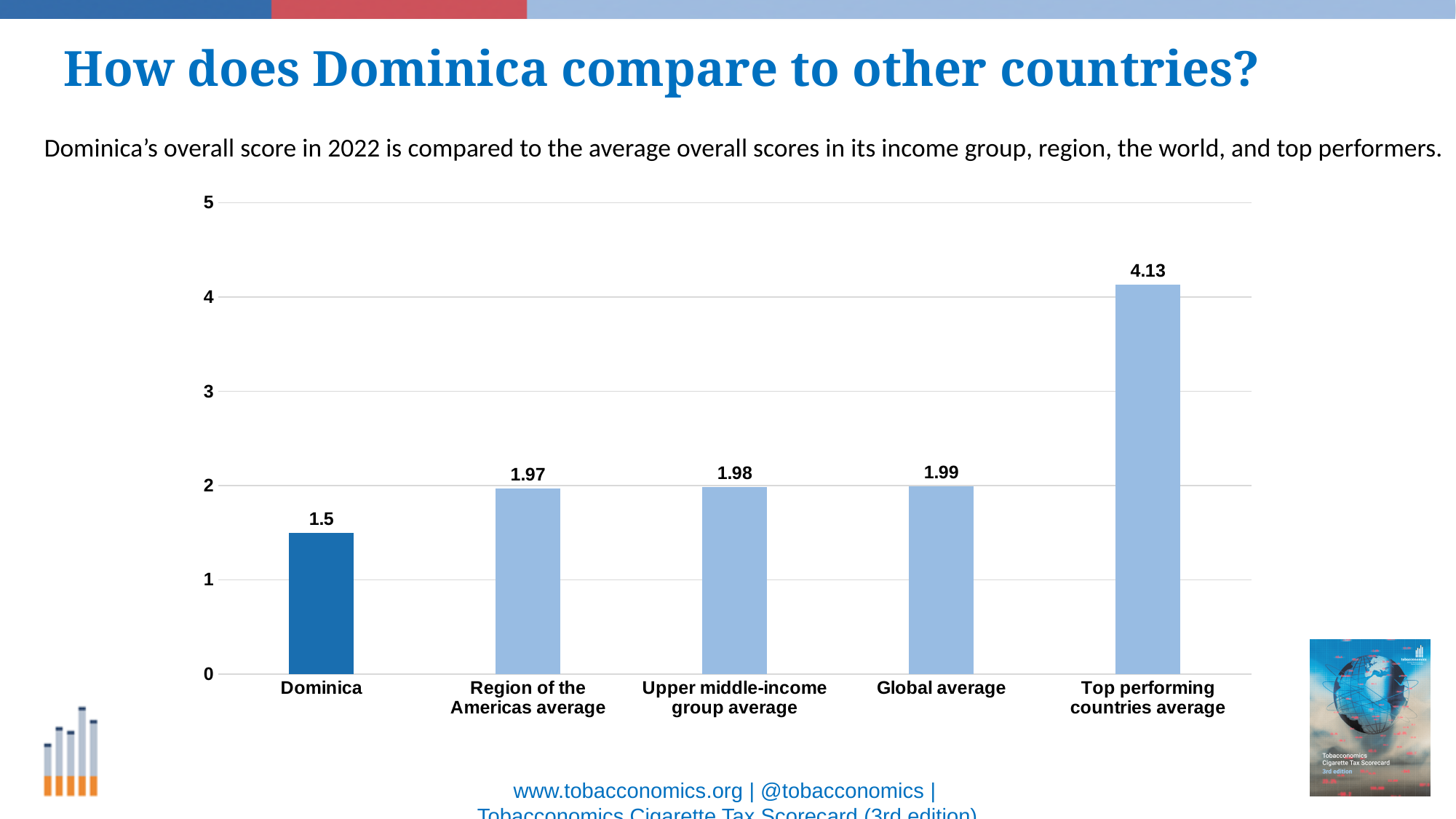
What is the value for the Upper middle-income group average? 1.98 What is the difference between the Global average and Dominica? 0.49 What is the value for Dominica? 1.5 Is the value for Dominica greater or less than 2? less How many categories are shown on the chart? 5 Which is larger, the value for Dominica or the Region of the Americas average? Region of the Americas average Which category has the lowest value? Dominica What is the difference between the Top performing countries average and Dominica? 2.63 What is the value for the Global average? 1.99 What is the value for the Top performing countries average? 4.13 Which category has the highest value? Top performing countries average What kind of chart is shown on the slide? bar chart